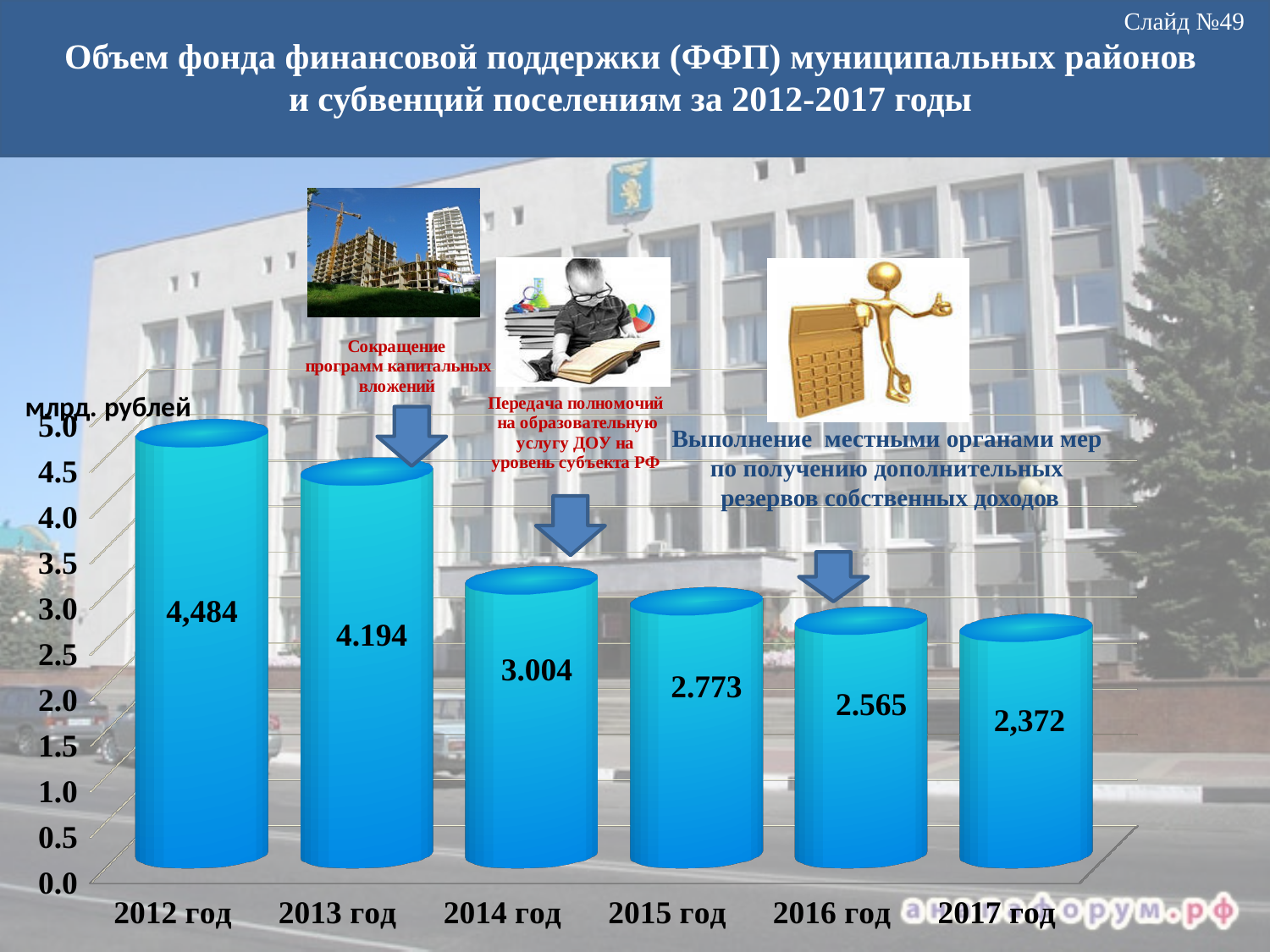
What is the difference between the values for 2014 год and 2015 год? 0.231 How many years are shown on the chart? 6 What is the value for 2017 год? 2,372 What is the value for 2014 год? 3.004 Which year has the highest value? 2012 год Do the values rise or fall from 2012 год to 2017 год? fall What is the value for 2016 год? 2.565 What is the value for 2012 год? 4,484 What is the difference between the values for 2015 год and 2016 год? 0.208 What kind of chart is shown on the slide? bar chart Which is larger, the value for 2013 год or the value for 2015 год? 2013 год Which year has the lowest value? 2017 год